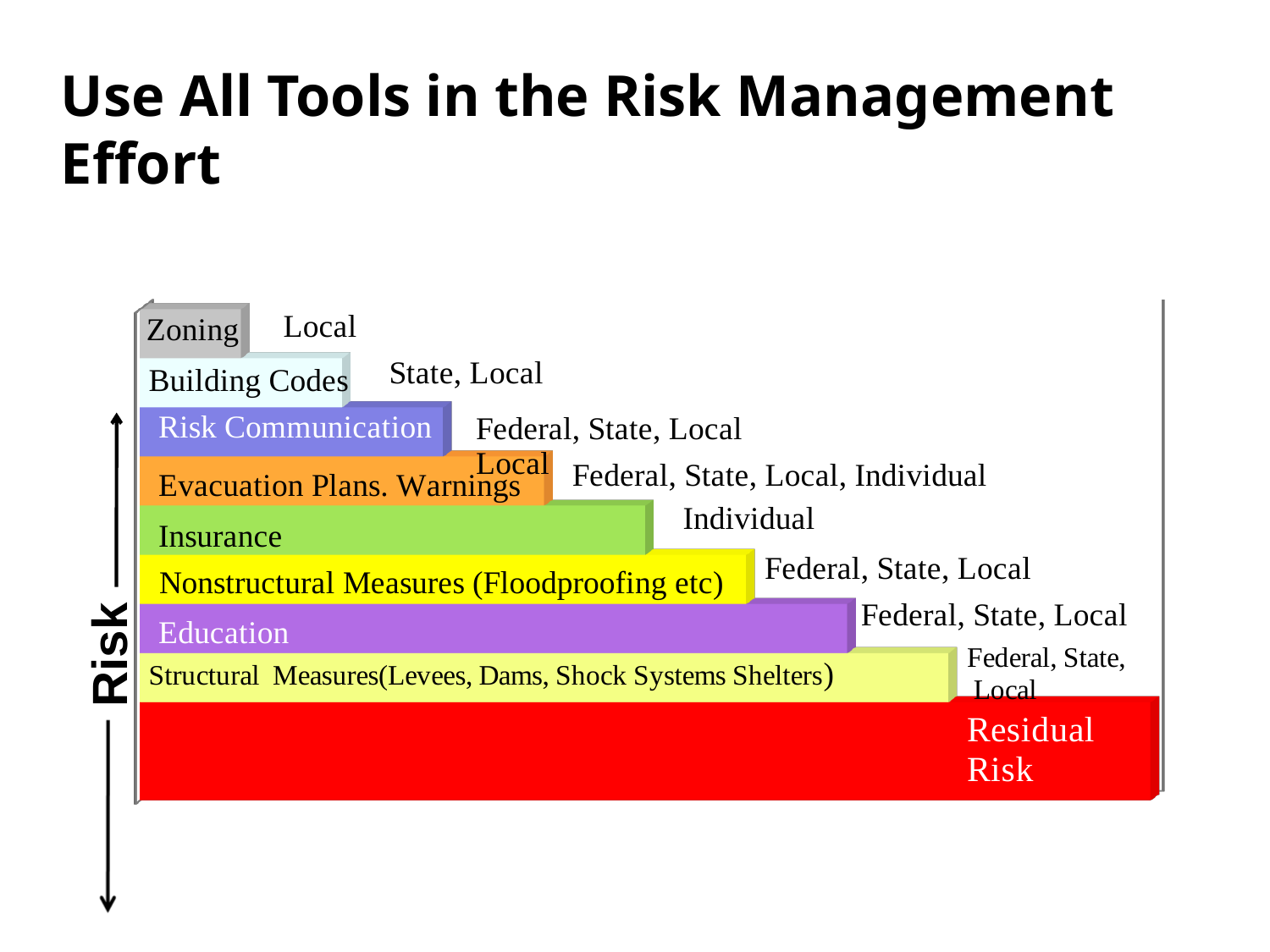
Which tool bar (excluding Residual Risk) is the widest in the chart? Structural Measures (Levees, Dams, Shock Systems Shelters) Which tool bar is the narrowest in the chart? Zoning Which bar is wider, Education or Risk Communication? Education What label is written along the vertical axis on the left of the chart? Risk Which level of government is listed next to the Zoning bar? Local Who is listed as responsible next to the Insurance bar? Individual What is the title of the slide containing the chart? Use All Tools in the Risk Management Effort Which levels are listed next to the Evacuation Plans. Warnings bar? Federal, State, Local, Individual Which levels are listed next to the Building Codes bar? State, Local What is the label on the bottom bar of the chart? Residual Risk Which bar is wider, Insurance or Building Codes? Insurance How many tool bars are stacked above the Residual Risk bar? 8